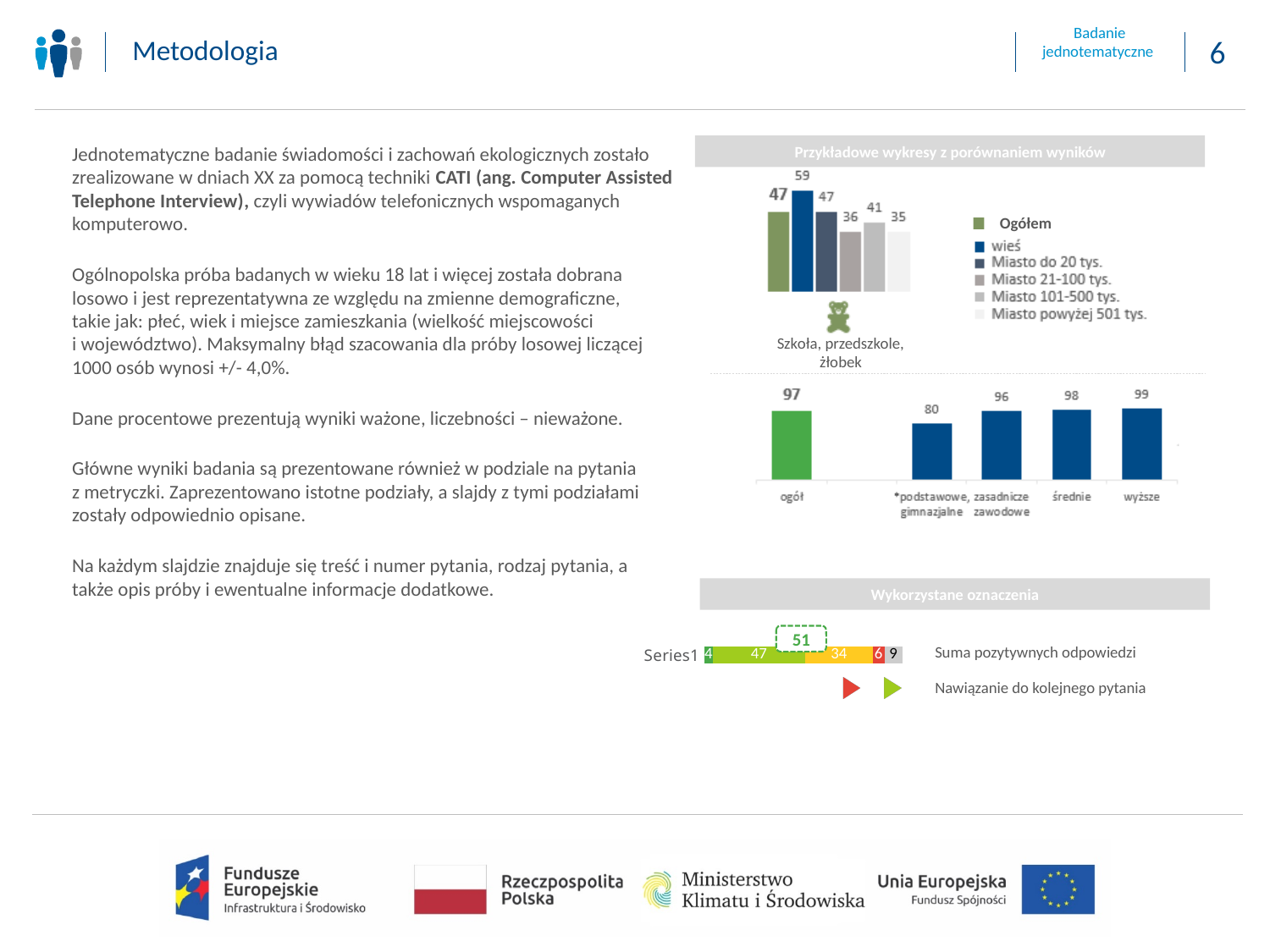
In the top chart (Szkoła, przedszkole, żłobek), which category has the lowest value? Miasto powyżej 501 tys. In the top chart (Szkoła, przedszkole, żłobek), what is the value for Ogółem? 47 In the middle chart (ogół / education levels), what is the difference between the values for wyższe and podstawowe, gimnazjalne? 19 In the middle chart (ogół / education levels), what is the value for ogół? 97 In the middle chart (ogół / education levels), which category has the lowest value? podstawowe, gimnazjalne In the middle chart (ogół / education levels), what is the value for wyższe? 99 What type of chart is the middle chart (ogół / education levels)? bar chart In the top chart (Szkoła, przedszkole, żłobek), which category has the highest value? wieś In the bottom stacked bar chart (Series1), what is the value shown in the dashed box as the sum of positive answers? 51 In the top chart (Szkoła, przedszkole, żłobek), what is the value for wieś? 59 How many series does the legend of the top chart (Szkoła, przedszkole, żłobek) list? 6 In the top chart (Szkoła, przedszkole, żłobek), what is the difference between the values for wieś and Miasto 21-100 tys.? 23